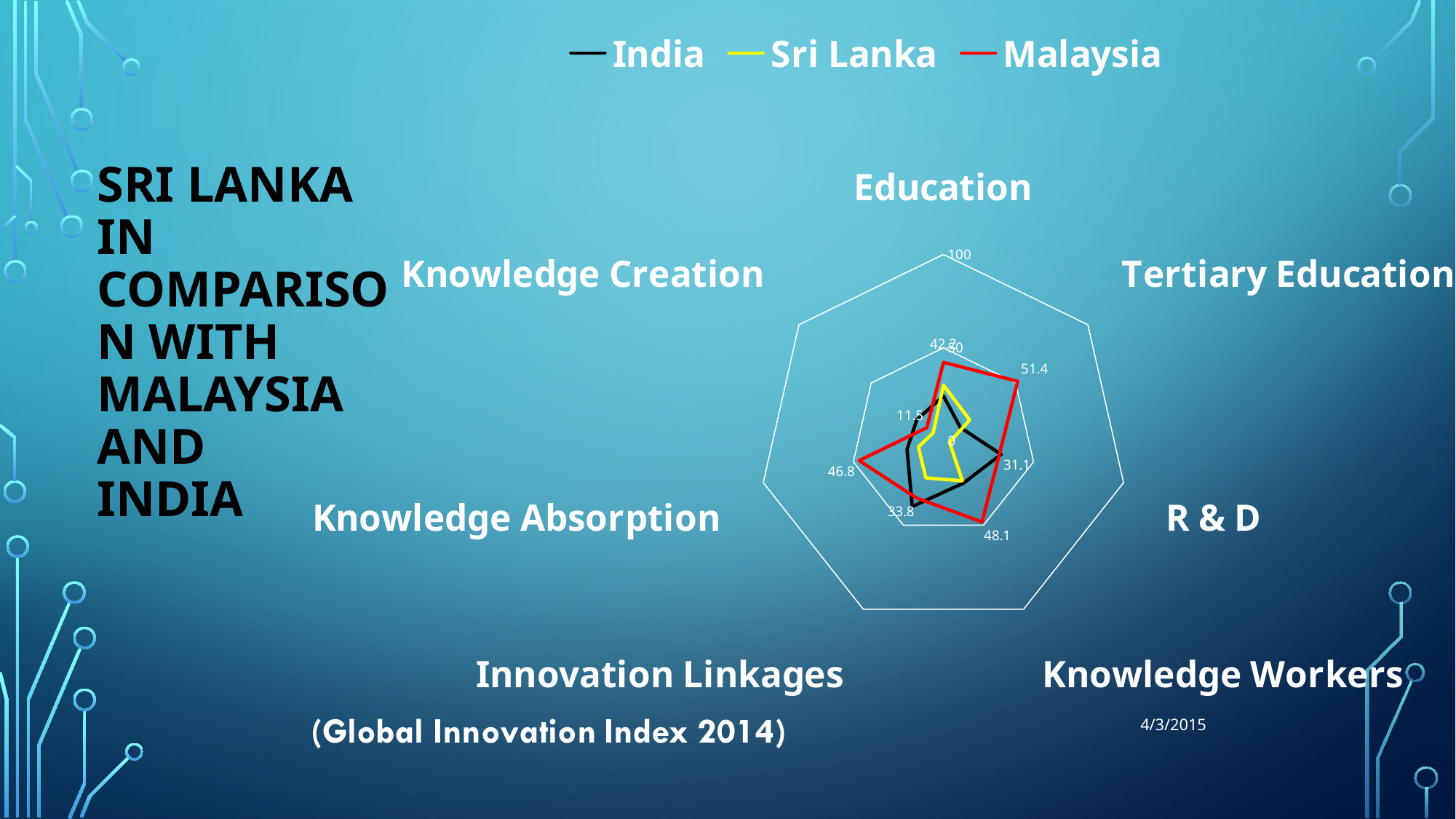
What is the difference between Malaysia's Tertiary Education value and its Knowledge Creation value? 39.9 For Knowledge Absorption, which has the larger value, Malaysia or India? Malaysia What kind of chart is shown on the slide? Radar chart What is Malaysia's value for Knowledge Creation? 11.5 How many categories (axes) does the radar chart have? 7 Which countries are listed in the chart legend? India, Sri Lanka, Malaysia What is Malaysia's value for Knowledge Absorption? 46.8 In which category does Malaysia have its lowest value? Knowledge Creation How many series does the legend list? 3 What is Malaysia's value for Tertiary Education? 51.4 What is Malaysia's value for Knowledge Workers? 48.1 In which category does Malaysia have its highest value? Tertiary Education